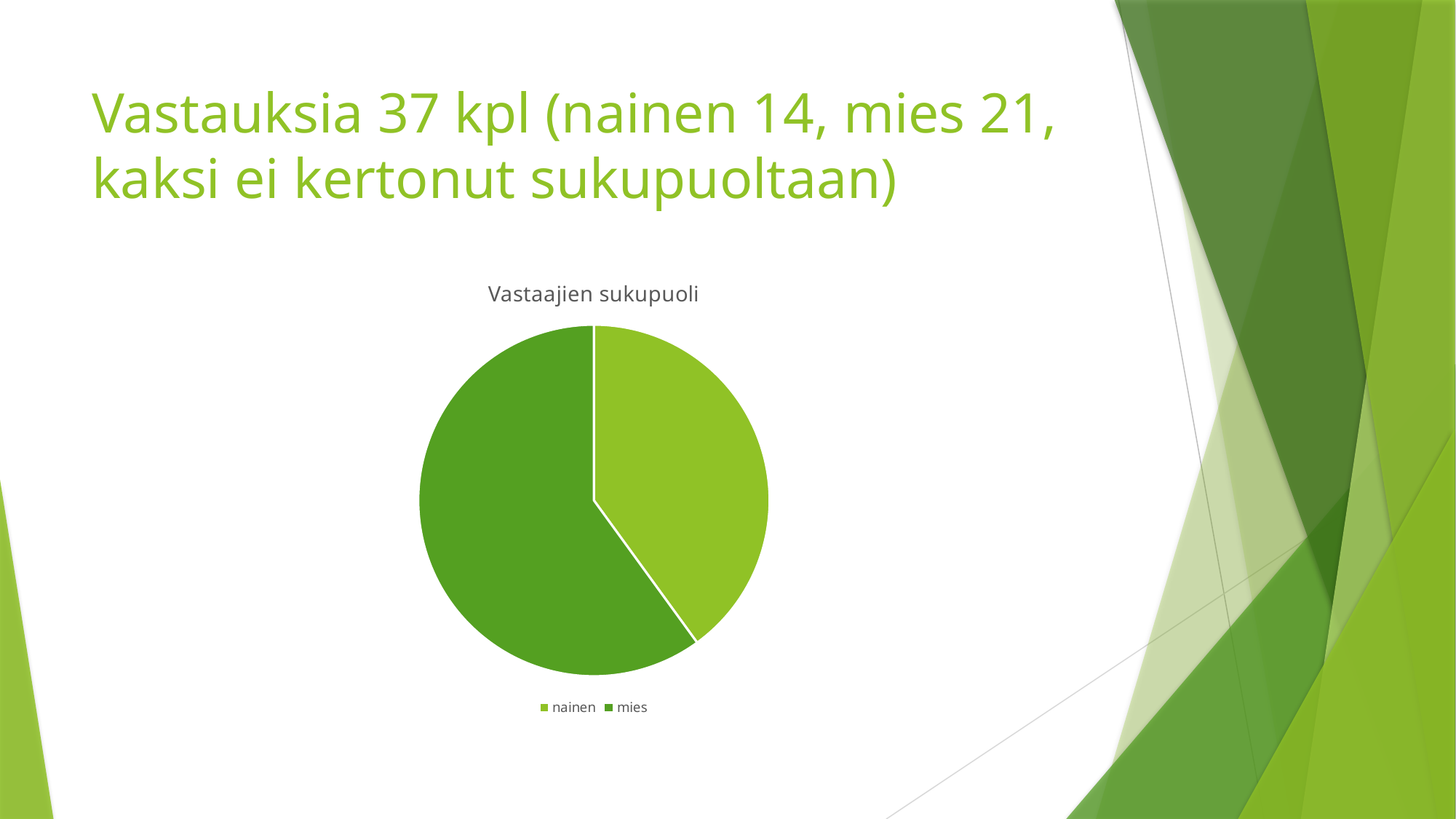
Which legend entry is shown in the lighter green colour? nainen What is the difference between the number of mies and nainen respondents? 7 According to the slide, how many respondents were nainen? 14 How many slices does the pie chart have? 2 Which category has the smallest slice of the pie? nainen How many entries does the legend list? 2 Which category has the largest slice of the pie? mies What kind of chart is shown on the slide? pie chart What share of the pie does the mies slice represent? 60% What is the title of the chart? Vastaajien sukupuoli According to the slide, how many respondents were mies? 21 Which slice is larger, nainen or mies? mies